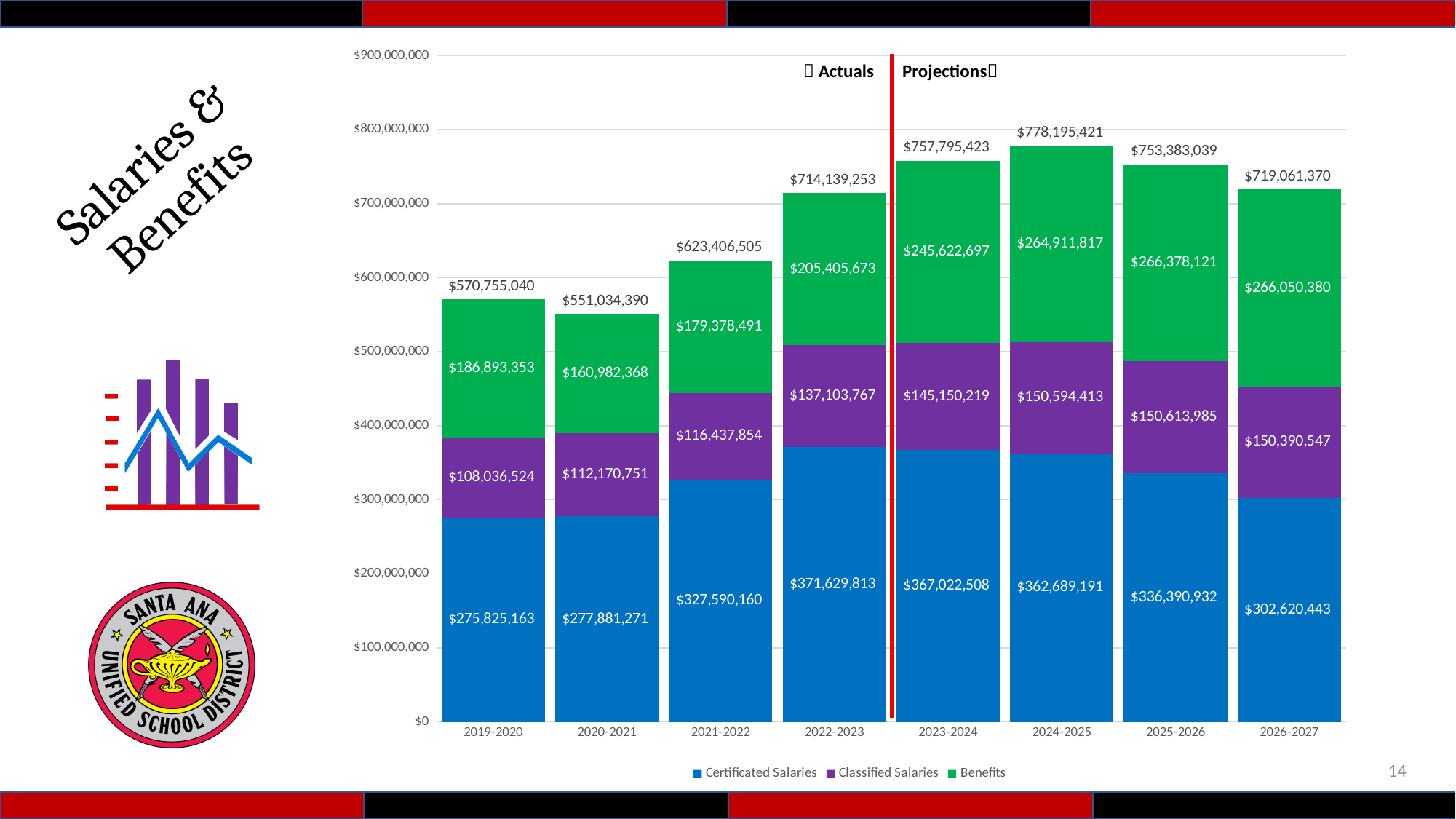
Which year has the highest total for salaries and benefits? 2024-2025 Which year has the lowest total for salaries and benefits? 2020-2021 What is the value of Benefits for 2024-2025? $264,911,817 What is the total of the stacked bar for 2024-2025? $778,195,421 What is the value of Certificated Salaries for 2022-2023? $371,629,813 What is the value of Classified Salaries for 2020-2021? $112,170,751 Do Certificated Salaries rise or fall from 2022-2023 to 2026-2027? Fall How many fiscal years are shown on the x axis? 8 What kind of chart is shown on the slide? Stacked bar chart How many series does the legend list? 3 What is the difference between Benefits in 2026-2027 and Benefits in 2019-2020? $79,157,027 Which is larger: Certificated Salaries in 2021-2022 or in 2025-2026? 2025-2026